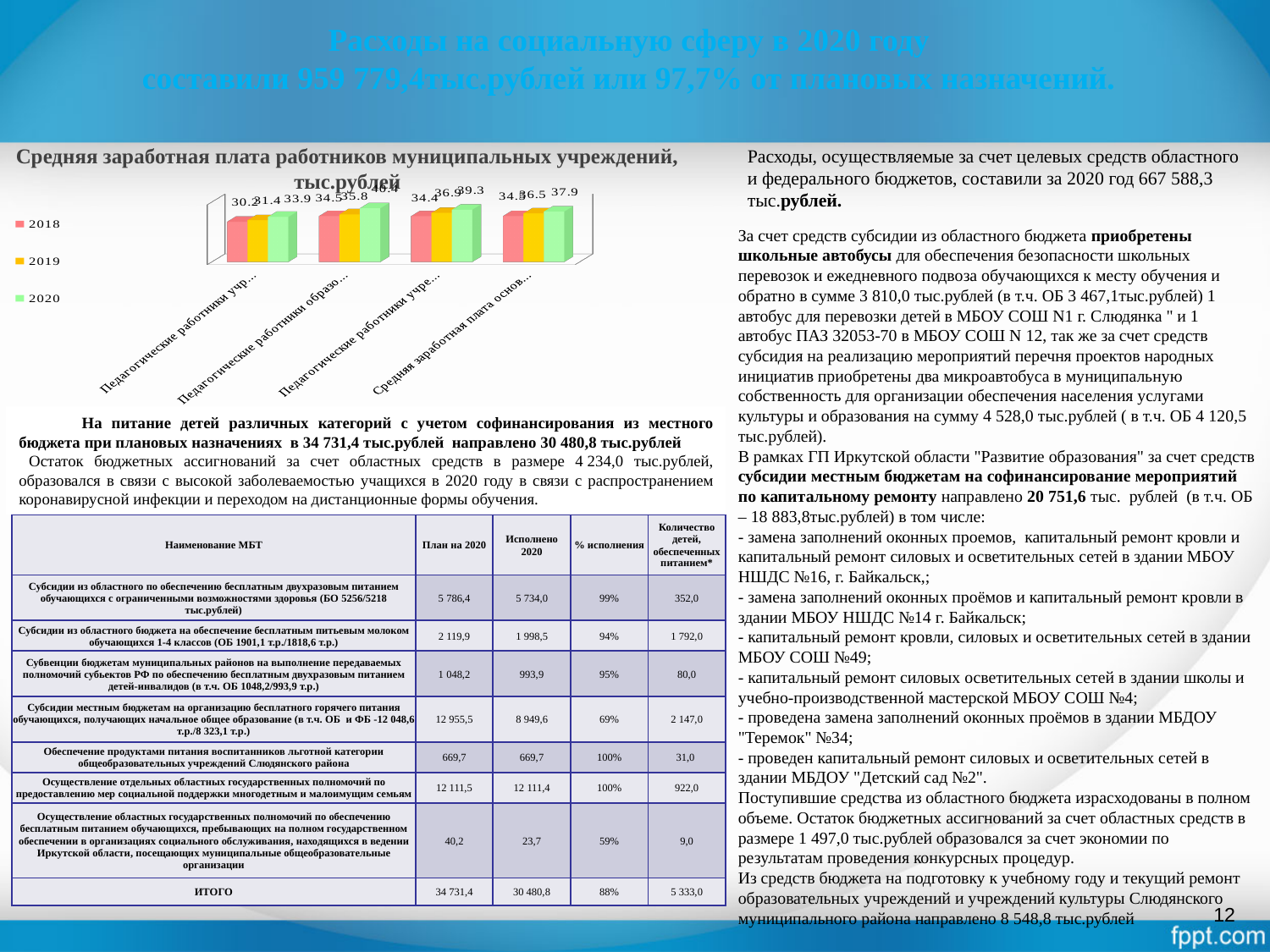
What is the 2018 value for the leftmost category in the chart? 30.2 What is the 2018 value for the category 'Средняя заработная плата основ...'? 34.5 For the category 'Средняя заработная плата основ...', what is the difference between the 2020 and 2018 values? 3.4 How many series does the legend of the chart list? 3 For the category 'Средняя заработная плата основ...', which is larger: the 2018 value or the 2020 value? 2020 How many categories are plotted along the x axis of the chart? 4 What is the 2020 value for the category 'Средняя заработная плата основ...'? 37.9 What kind of chart is shown on the slide? bar chart Which years are listed in the chart legend? 2018, 2019, 2020 What is the 2019 value for the category 'Средняя заработная плата основ...'? 36.5 What is the 2019 value for the category 'Педагогические работники образо...'? 35.8 Do the values for the category 'Средняя заработная плата основ...' rise or fall from 2018 to 2020? rise